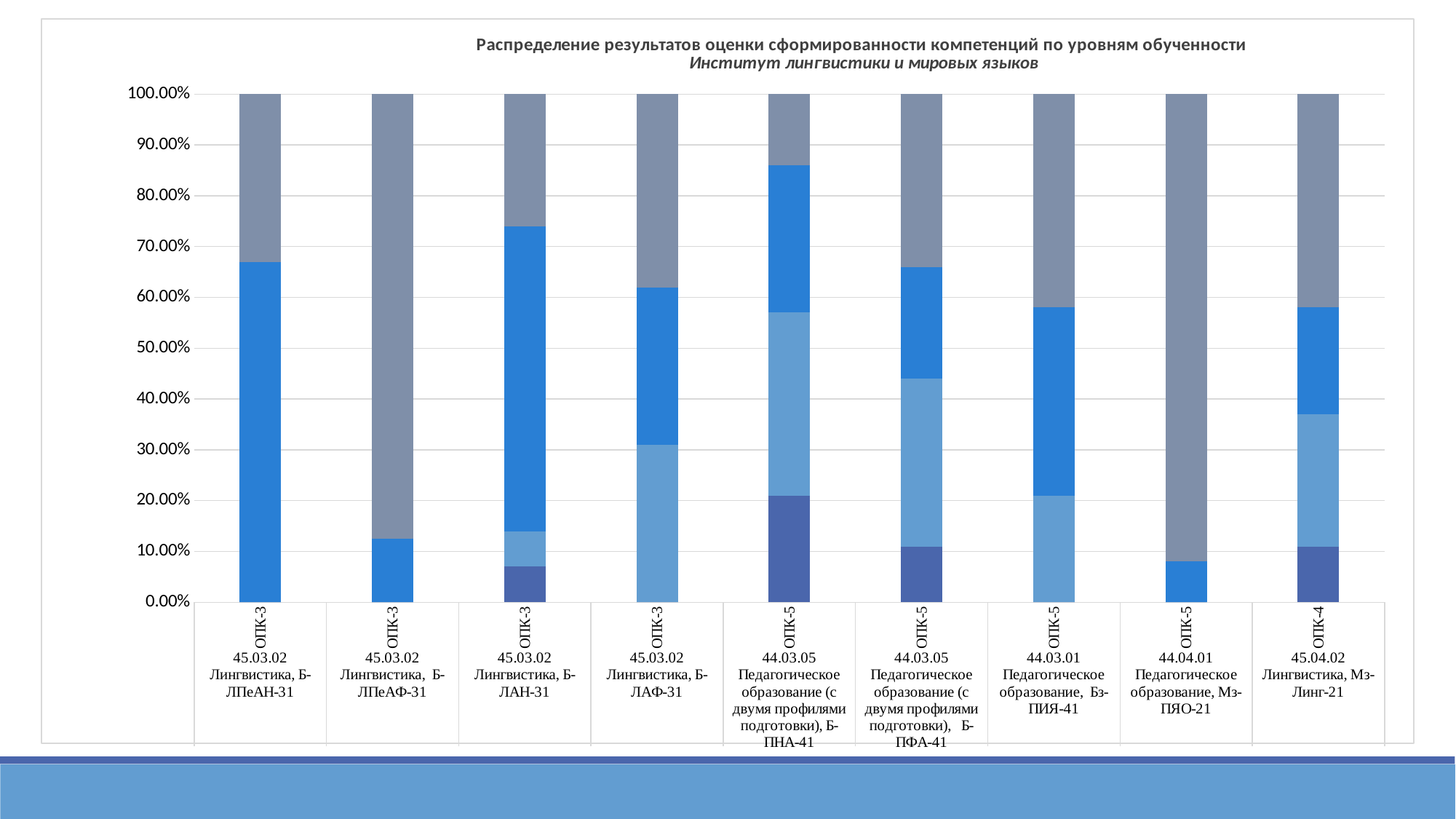
Which institute is named in the chart's subtitle? Институт лингвистики и мировых языков How many bars (categories) are plotted in the chart? 9 In the bar for 44.04.01 Педагогическое образование, Мз-ПЯО-21, is the boundary between the blue and grey segments greater or less than 10.00%? less Which bar has the largest dark navy (bottom) segment? 44.03.05 Педагогическое образование (с двумя профилями подготовки), Б-ПНА-41 Is the grey segment larger in the bar for 45.03.02 Лингвистика, Б-ЛПеАФ-31 or in the bar for 45.03.02 Лингвистика, Б-ЛАН-31? 45.03.02 Лингвистика, Б-ЛПеАФ-31 What is the total height of the stacked bar for 45.03.02 Лингвистика, Б-ЛПеАН-31 (ОПК-3)? 100.00% In the bar for 45.03.02 Лингвистика, Б-ЛПеАН-31, is the boundary between the blue and grey segments greater or less than 60.00%? greater Which bar has the smallest grey (top) segment? 44.03.05 Педагогическое образование (с двумя профилями подготовки), Б-ПНА-41 What kind of chart is shown on the slide? Stacked bar chart Which bar has the largest grey (top) segment? 44.04.01 Педагогическое образование, Мз-ПЯО-21 How many bars include a dark navy segment at the bottom? 4 What is the first line of the chart title? Распределение результатов оценки сформированности компетенций по уровням обученности